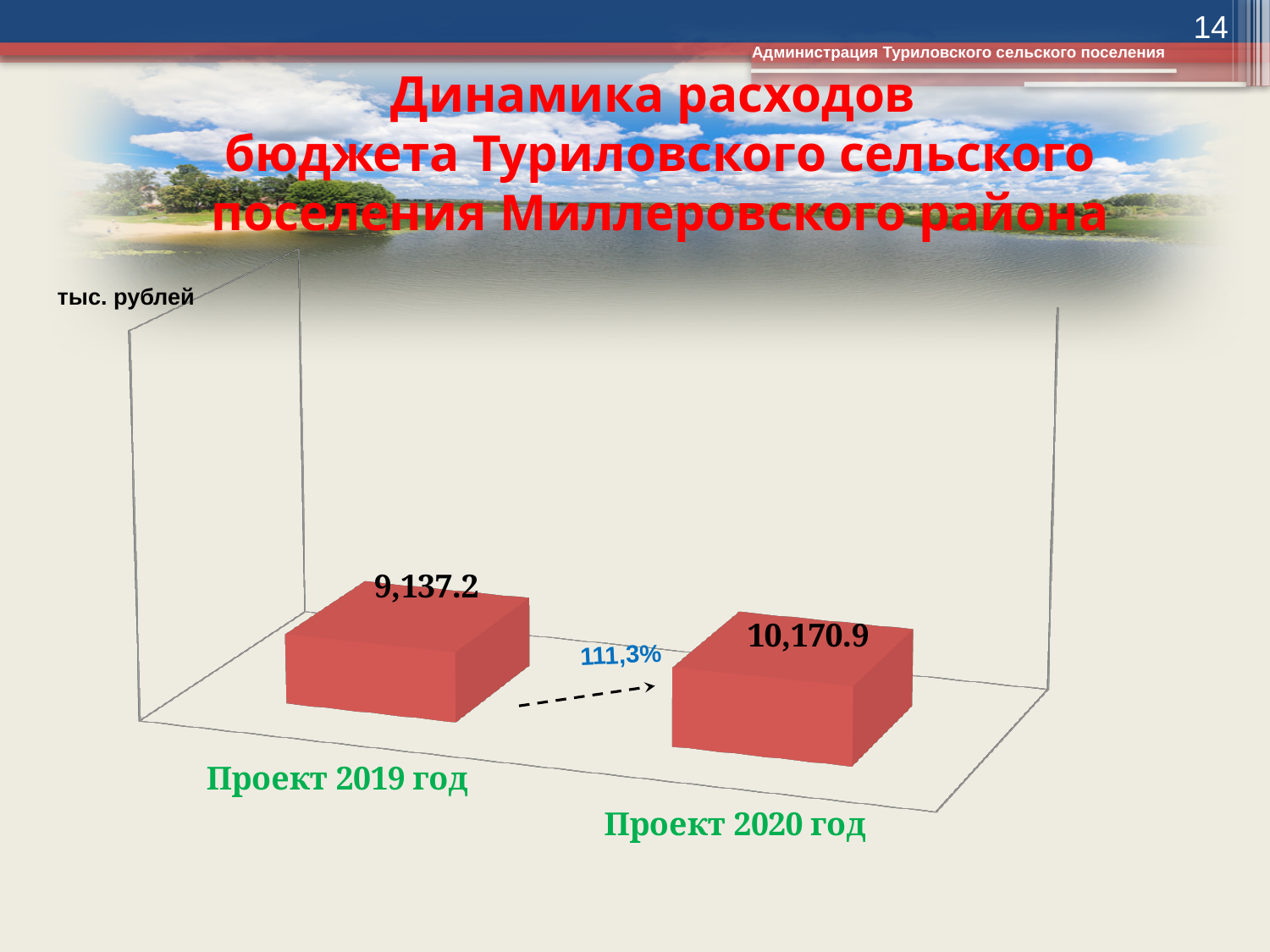
What kind of chart is shown on the slide? Bar chart What is the difference between the values for Проект 2020 год and Проект 2019 год? 1,033.7 What is the value for Проект 2020 год? 10,170.9 Which category has the highest value? Проект 2020 год How many categories are shown in the chart? 2 What unit is indicated for the chart values? тыс. рублей What percentage is printed next to the arrow between the two bars? 111,3% Do the values rise or fall from Проект 2019 год to Проект 2020 год? Rise Which category has the lowest value? Проект 2019 год Which is larger, the value for Проект 2019 год or Проект 2020 год? Проект 2020 год What is the value for Проект 2019 год? 9,137.2